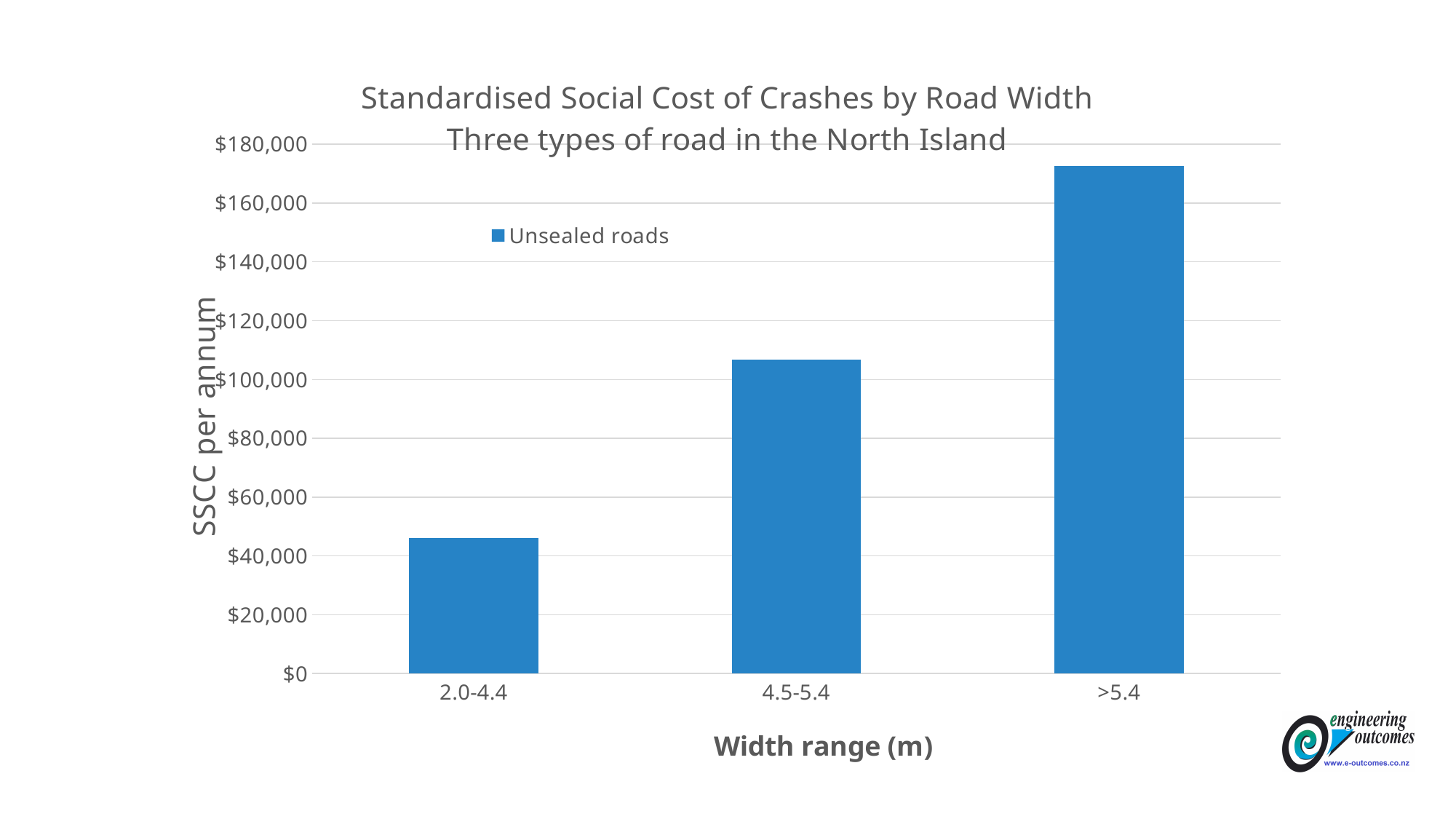
Which has a larger SSCC per annum, the 4.5-5.4 width range or the >5.4 width range? >5.4 What series name is shown in the chart legend? Unsealed roads Which width range has the lowest SSCC per annum? 2.0-4.4 What kind of chart is shown on the slide? bar chart Is the SSCC per annum for the >5.4 width range greater or less than $160,000? greater Which width range has the highest SSCC per annum? >5.4 How many series does the legend list? 1 Is the SSCC per annum for the 2.0-4.4 width range greater or less than $60,000? less How many width range categories are plotted on the x axis? 3 Do the SSCC per annum values rise or fall as the width range increases along the x axis? rise What is the label of the x axis? Width range (m) Is the SSCC per annum for the 4.5-5.4 width range greater or less than $100,000? greater